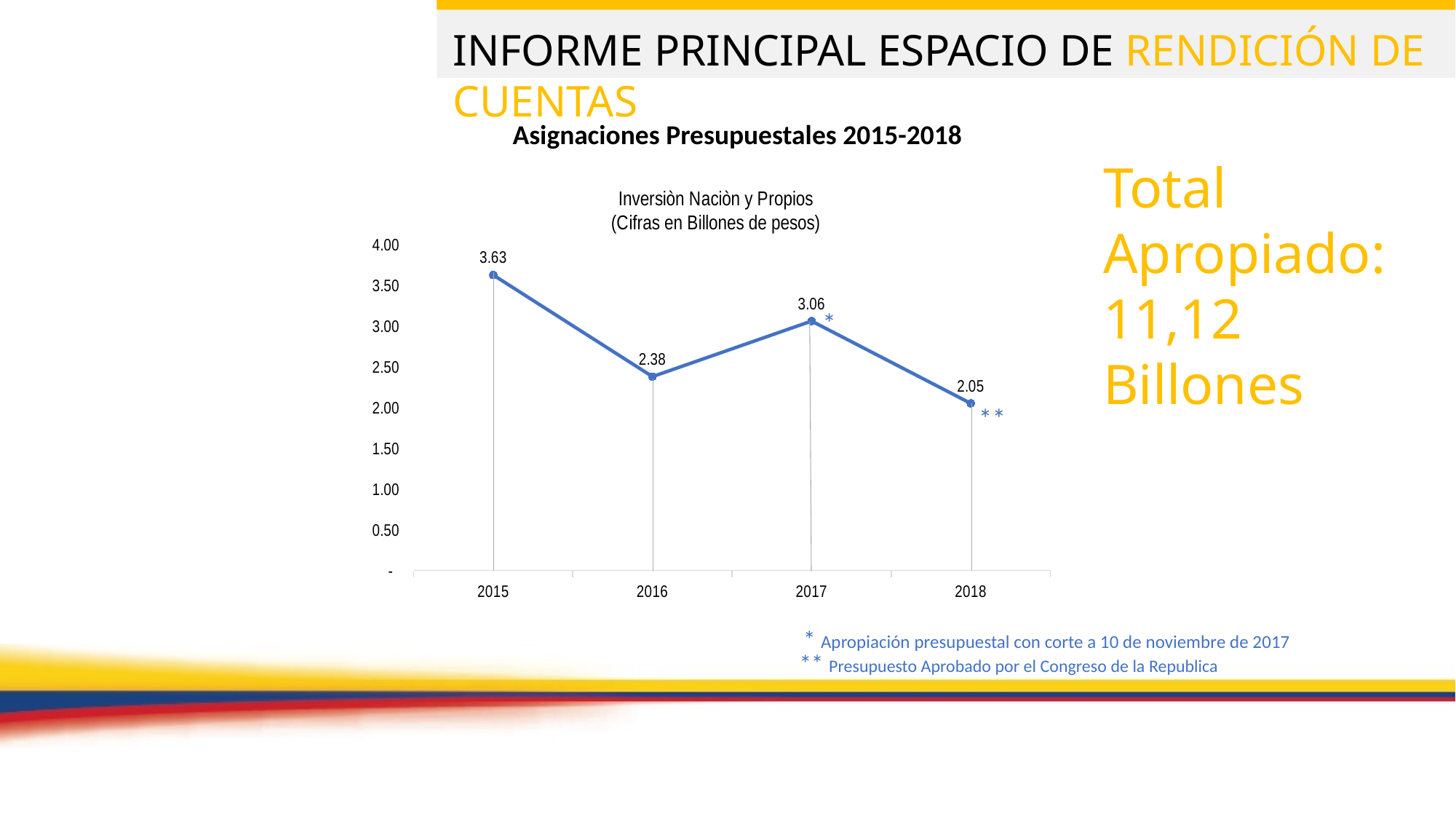
Which year has the lowest value? 2018 What kind of chart is shown? line chart What is the value for 2017? 3.06 Which year has the highest value? 2015 What is the title of the chart? Inversiòn Naciòn y Propios (Cifras en Billones de pesos) What is the value for 2015? 3.63 Which is larger, the value for 2016 or the value for 2017? 2017 What is the value for 2018? 2.05 How many years are plotted on the chart? 4 Is the value for 2017 greater or less than 3.00? greater What is the value for 2016? 2.38 What is the difference between the values for 2015 and 2016? 1.25